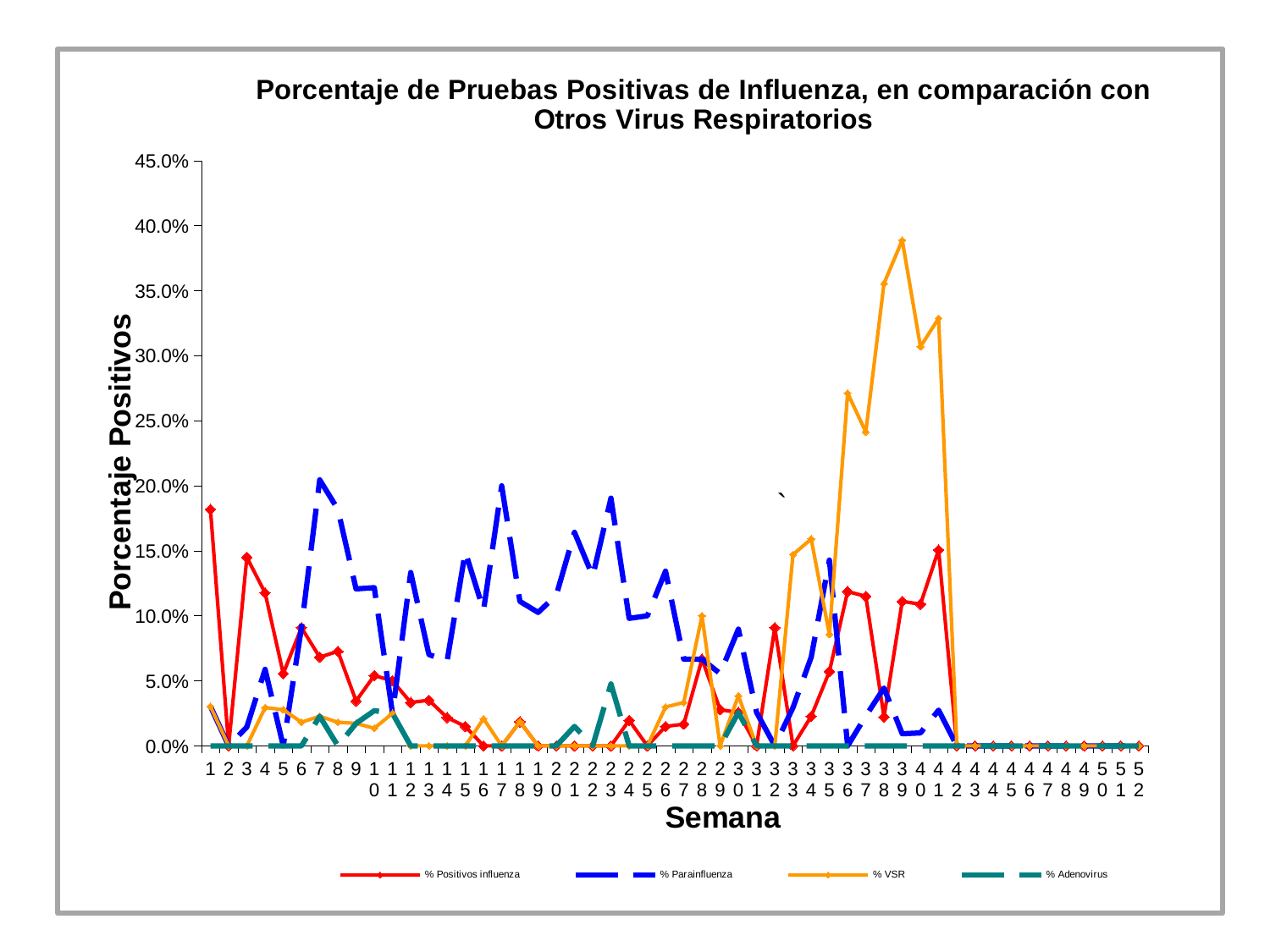
How many weeks (Semana) are plotted along the x axis? 52 Between week 36 and week 39, does the % VSR line generally rise or fall? rise At week 39, which is larger: % VSR or % Positivos influenza? % VSR What is the label on the y axis of the chart? Porcentaje Positivos Is the value for % Adenovirus at week 23 greater or less than 10.0%? less Is the value for % VSR at week 39 greater or less than 35.0%? greater What is the title of the chart? Porcentaje de Pruebas Positivas de Influenza, en comparación con Otros Virus Respiratorios Which series reaches the highest value anywhere on the chart? % VSR How many series does the legend list? 4 Is the value for % Positivos influenza at week 1 greater or less than 15.0%? greater What kind of chart is shown on the slide? line chart